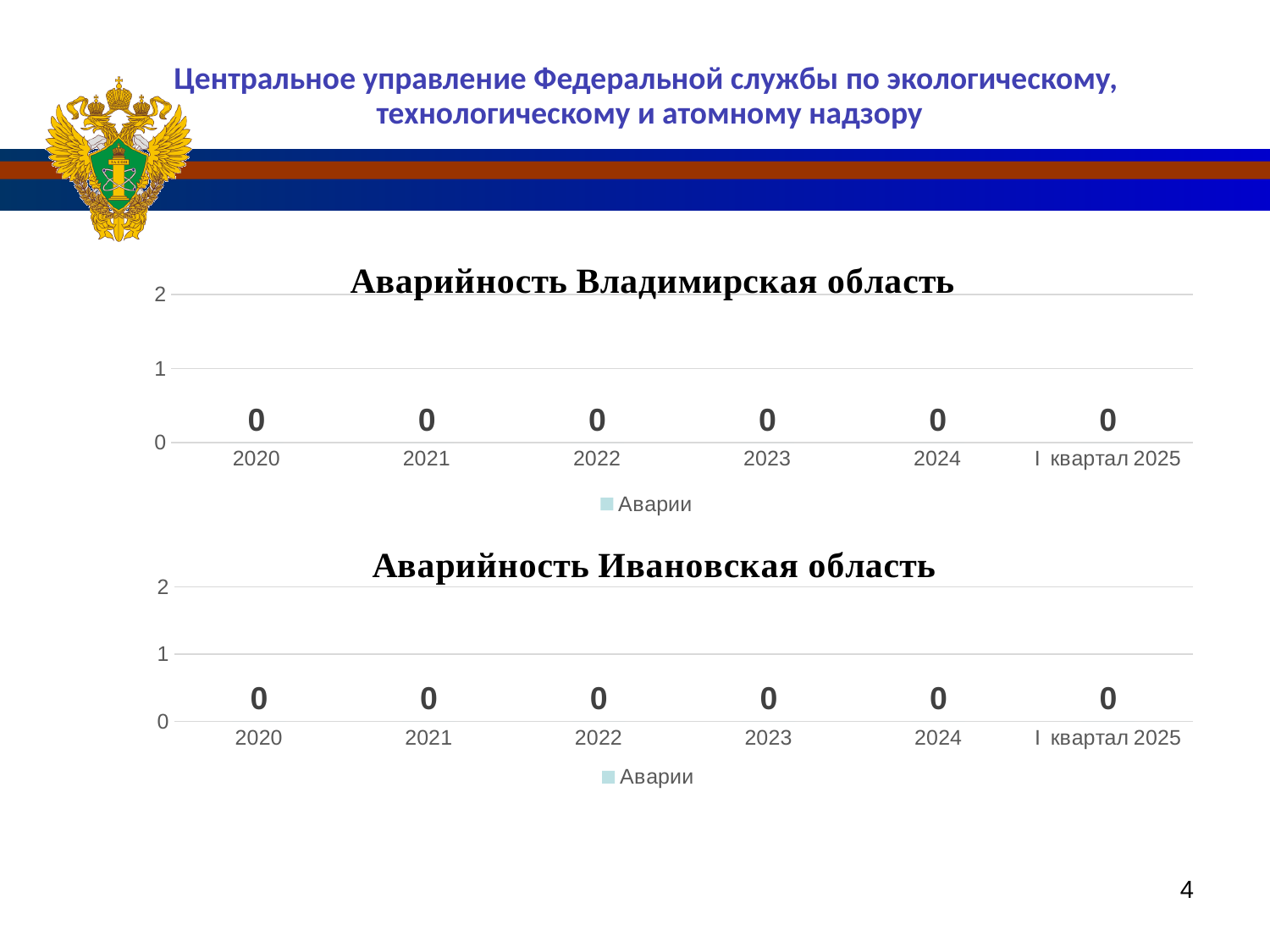
In the chart titled "Аварийность Владимирская область", what is the value for I квартал 2025? 0 In the chart titled "Аварийность Владимирская область", what is the difference between the values for 2021 and 2022? 0 How many series does the legend list in the chart titled "Аварийность Владимирская область"? 1 In the chart titled "Аварийность Владимирская область", what is the value for 2020? 0 How many categories are shown on the x axis of the chart titled "Аварийность Ивановская область"? 6 How many categories are shown on the x axis of the chart titled "Аварийность Владимирская область"? 6 What is the title of the lower chart on the slide? Аварийность Ивановская область In the chart titled "Аварийность Ивановская область", what is the value for 2023? 0 In the chart titled "Аварийность Ивановская область", what is the value for 2024? 0 In the chart titled "Аварийность Ивановская область", is the value for 2022 greater or less than 1? less In the chart titled "Аварийность Владимирская область", do the values rise, fall or stay flat from 2020 to I квартал 2025? stay flat What is the name of the series in the legend of the chart titled "Аварийность Ивановская область"? Аварии